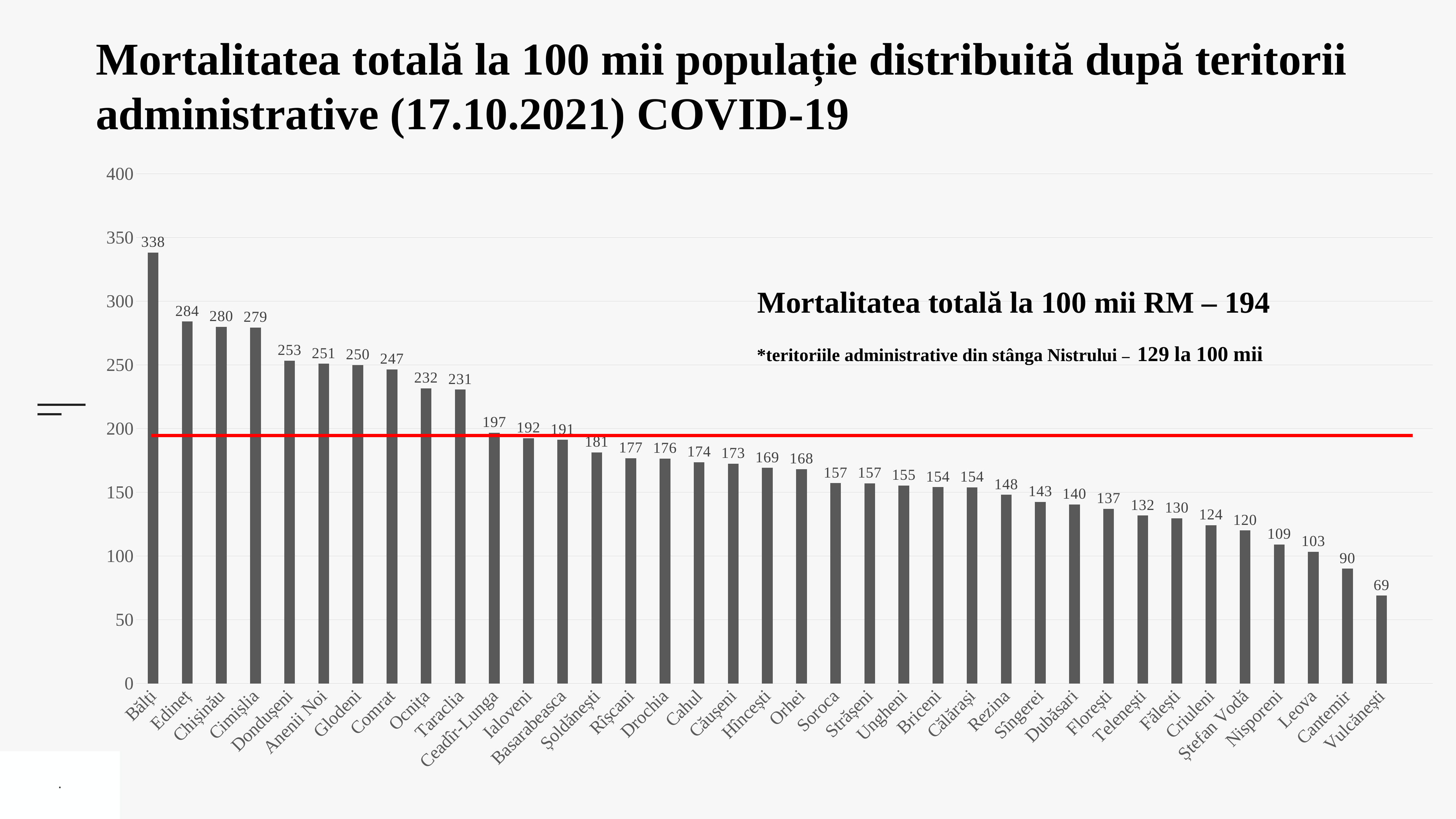
Which territory has the lowest value? Vulcănești What value does the text on the slide give for total mortality per 100 thousand in RM? 194 What is the difference between the values for Bălți and Edineț? 54 Which is larger, the value for Orhei or the value for Soroca? Orhei How many territories are shown on the x axis? 37 Which territory has the highest value? Bălți What kind of chart is shown on the slide? Bar chart What is the value for Bălți? 338 Do the values rise or fall from left to right along the x axis? Fall What is the value for Vulcănești? 69 What is the value for Cahul? 174 What is the value for Chișinău? 280